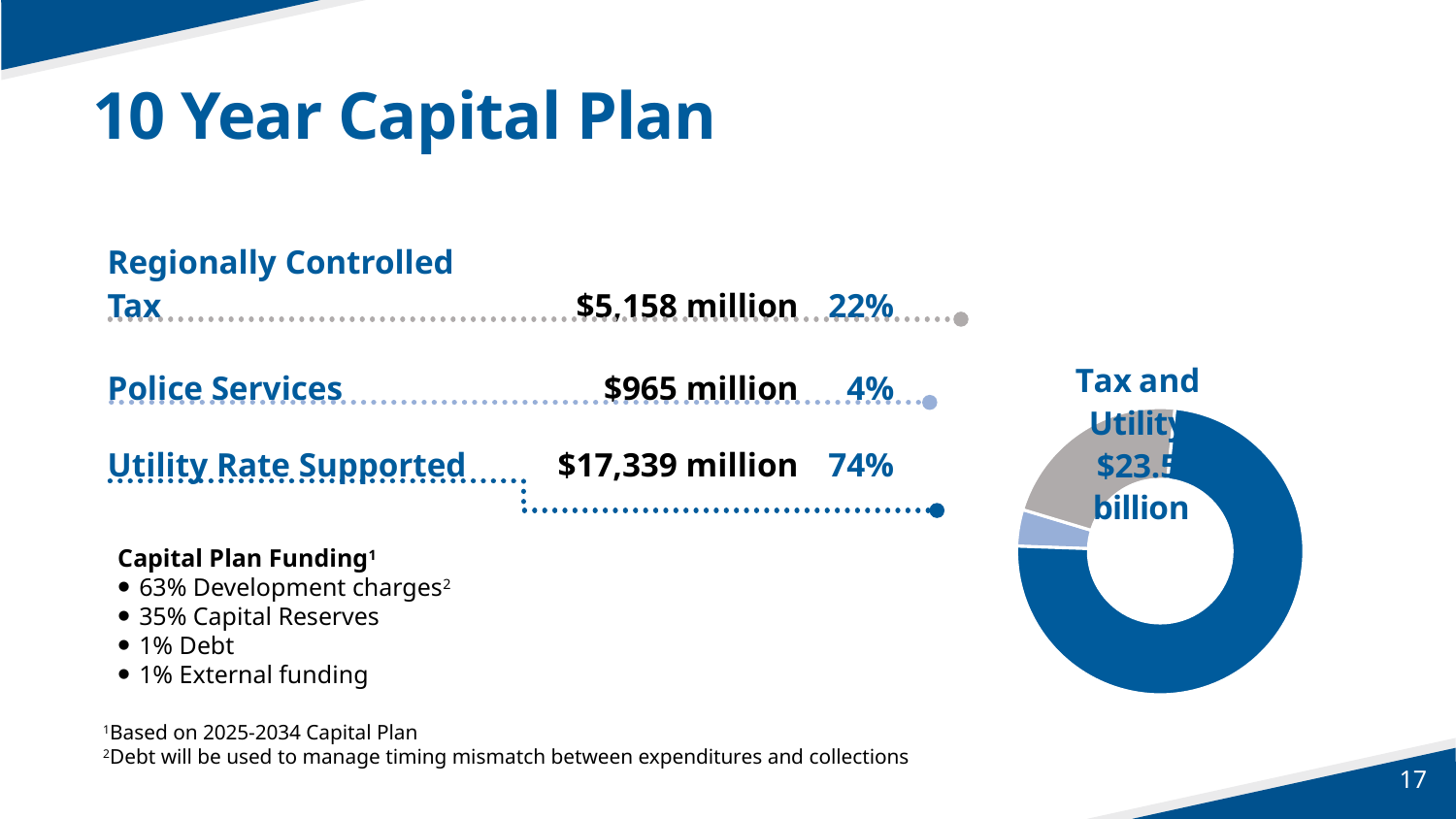
Which category has the smallest slice of the donut chart? Police Services Which is larger, the Tax share or the Police Services share? Tax Which category has the largest slice of the donut chart? Utility Rate Supported What share of the donut chart is Police Services? 4% What share of the donut chart is Utility Rate Supported? 74% What share of the donut chart is Tax? 22% What is the dollar value for Police Services? $965 million What is the dollar value for Utility Rate Supported? $17,339 million What is the dollar value for Tax? $5,158 million What kind of chart is shown on the slide? Pie chart (donut) What is the difference in percentage points between the Utility Rate Supported share and the Tax share? 52% How many slices does the donut chart have? 3